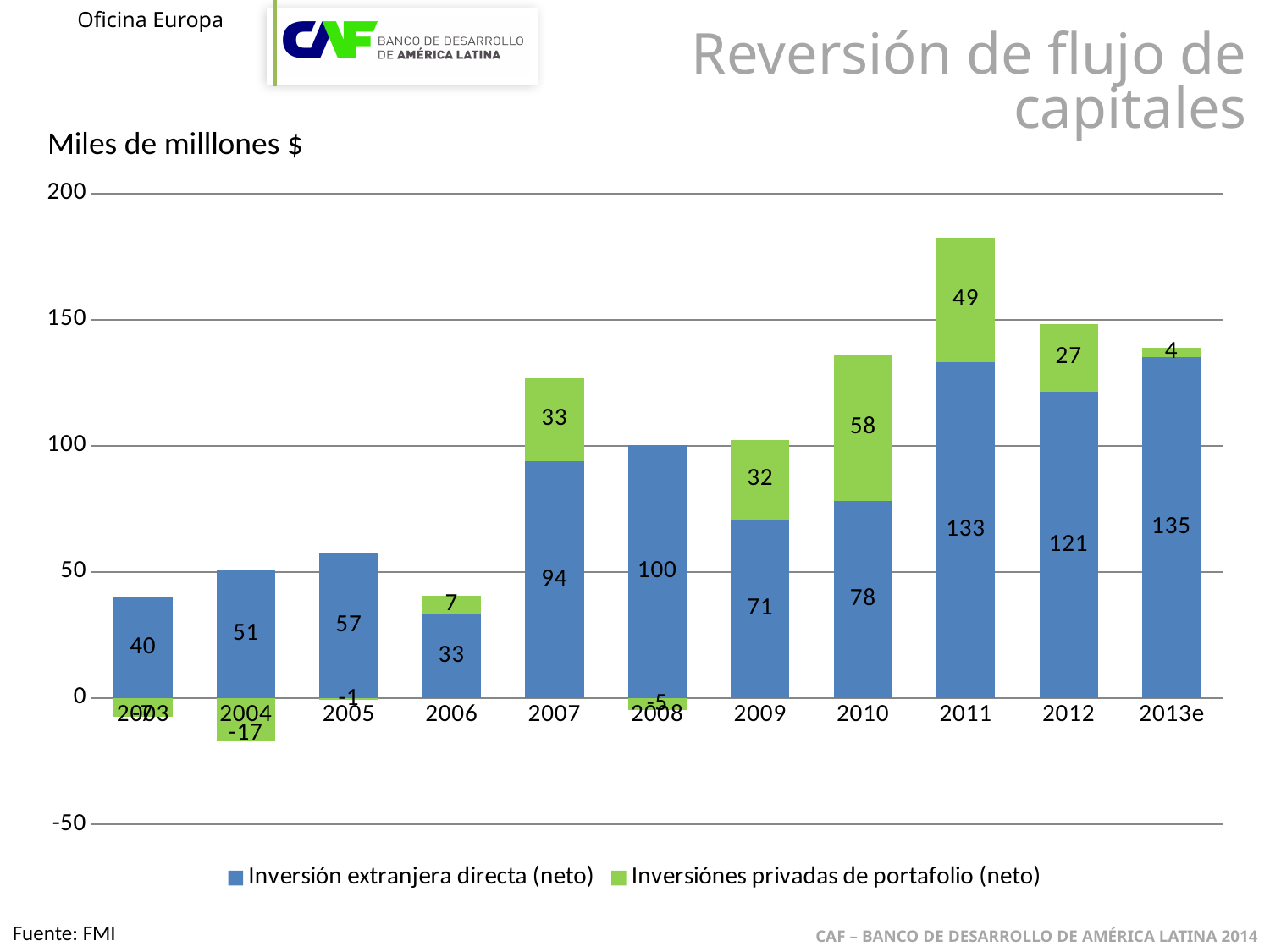
What is the difference between Inversión extranjera directa (neto) in 2012 and in 2009? 50 What kind of chart is shown on the slide? Stacked bar chart What is the total of the stacked bar for 2011? 182 In which year is Inversión extranjera directa (neto) highest? 2013e What is the value of Inversiónes privadas de portafolio (neto) for 2010? 58 Which is larger: Inversiónes privadas de portafolio (neto) in 2007 or in 2012? 2007 In which year is Inversiónes privadas de portafolio (neto) highest? 2010 How many years are shown on the x axis? 11 What is the value of Inversión extranjera directa (neto) for 2011? 133 How many series does the legend list? 2 In which year is Inversión extranjera directa (neto) lowest? 2006 What is the value of Inversiónes privadas de portafolio (neto) for 2004? -17